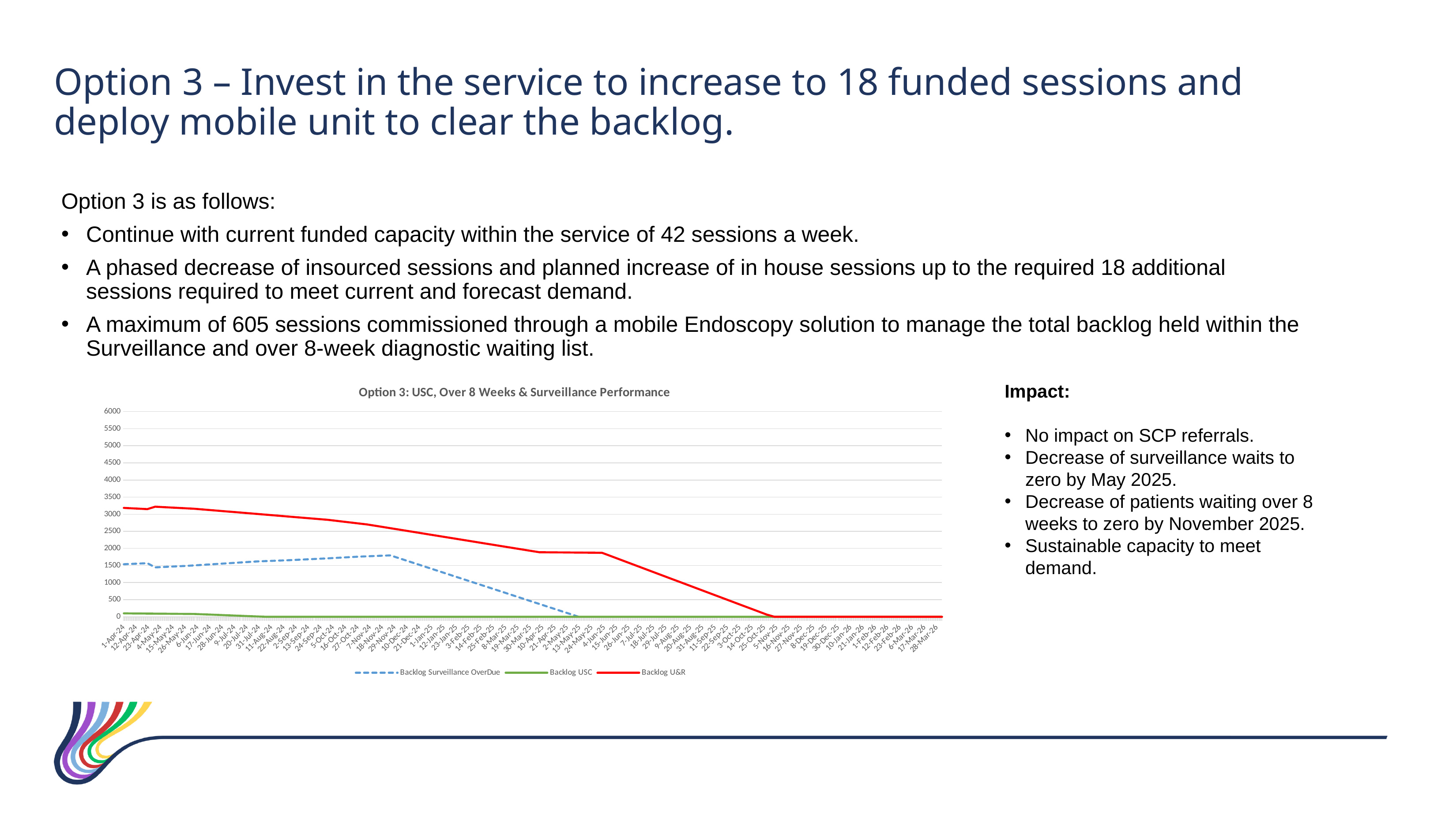
What kind of chart is shown on the slide? line chart Is the value for Backlog U&R at 5-Nov-25 greater or less than 500? less Which series in the chart is drawn as a dashed line? Backlog Surveillance OverDue Is the value for Backlog U&R at 4-Jun-25 greater or less than 1500? greater What is the title of the chart? Option 3: USC, Over 8 Weeks & Surveillance Performance Is the value for Backlog USC at 1-Apr-24 greater or less than 500? less At 1-Apr-24, which is higher: Backlog U&R or Backlog Surveillance OverDue? Backlog U&R Does the Backlog U&R series rise or fall over the period shown on the x axis? fall How many series does the chart legend list? 3 Which series has the highest value at 1-Apr-24? Backlog U&R